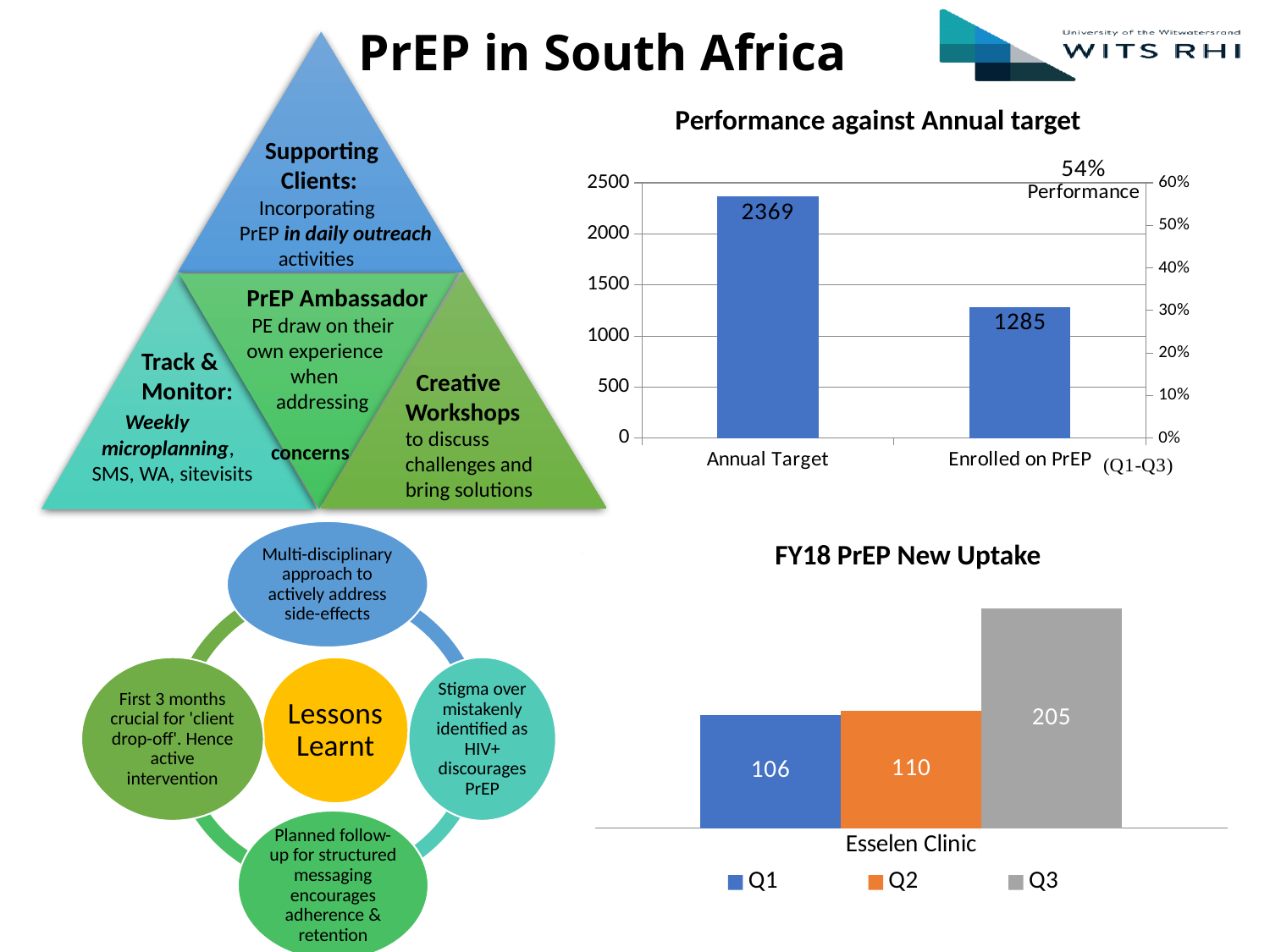
In the 'FY18 PrEP New Uptake' chart, what is the difference between the Q3 and Q2 values? 95 In the 'FY18 PrEP New Uptake' chart, which quarter has the highest value? Q3 In the 'FY18 PrEP New Uptake' chart, what is the value for Q1? 106 In the 'FY18 PrEP New Uptake' chart, how many series does the legend list? 3 In the 'Performance against Annual target' chart, which category has the lower value? Enrolled on PrEP In the 'Performance against Annual target' chart, how many bars are plotted? 2 In the 'Performance against Annual target' chart, what is the value for Enrolled on PrEP? 1285 What kind of chart is the 'FY18 PrEP New Uptake' chart? Bar chart In the 'Performance against Annual target' chart, what is the difference between the Annual Target and Enrolled on PrEP values? 1084 In the 'FY18 PrEP New Uptake' chart, what is the value for Q3 at Esselen Clinic? 205 In the 'Performance against Annual target' chart, what percentage is shown for Performance? 54% In the 'Performance against Annual target' chart, what is the value for Annual Target? 2369